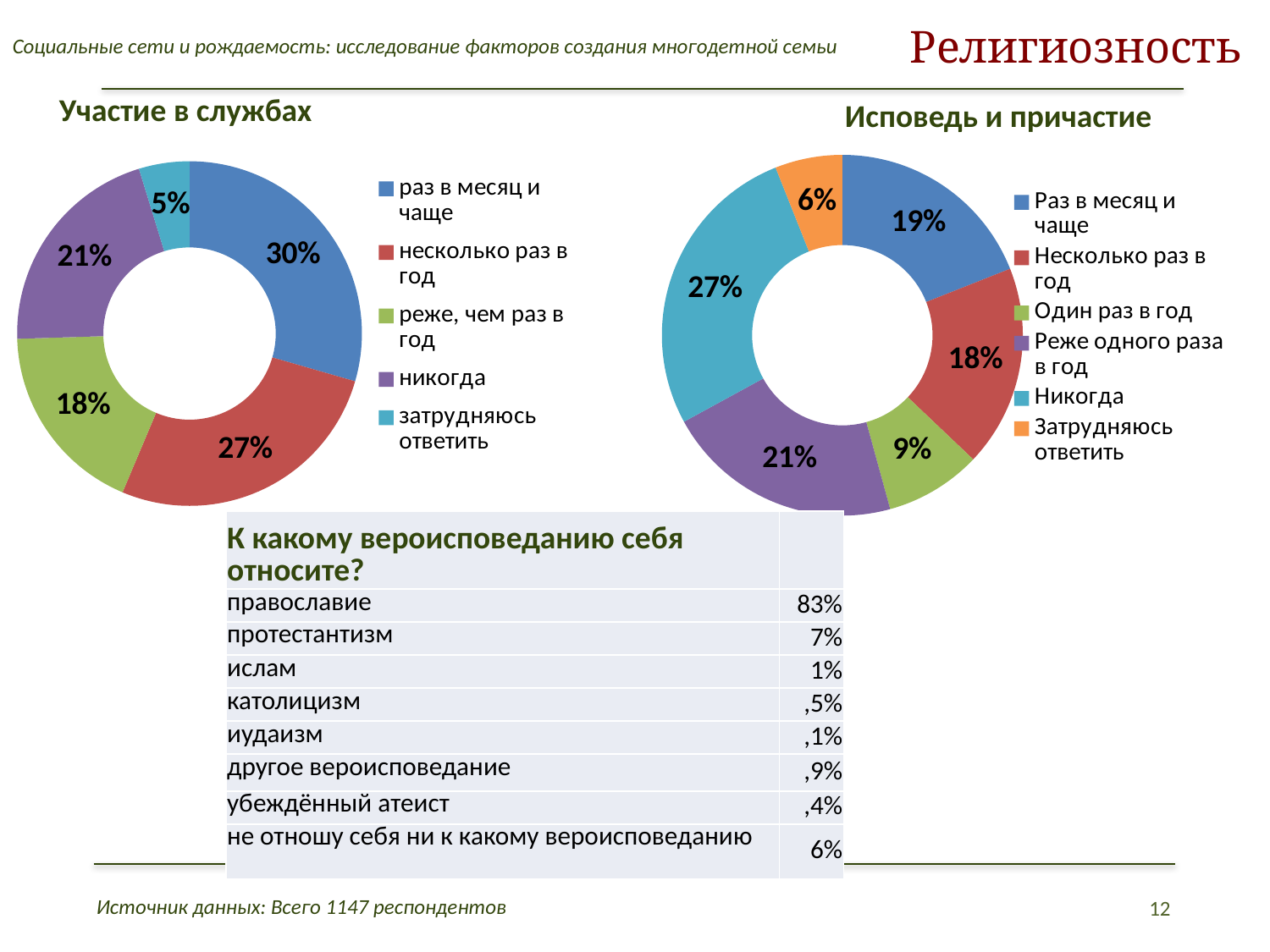
What type of chart is used for 'Участие в службах'? Donut (pie) chart In the 'Участие в службах' chart, which category has the smallest share? затрудняюсь ответить In the 'Исповедь и причастие' chart, which is larger: 'Раз в месяц и чаще' or 'Реже одного раза в год'? Реже одного раза в год In the 'Участие в службах' chart, what is the difference between 'несколько раз в год' and 'реже, чем раз в год'? 9% In the 'Исповедь и причастие' chart, what share of respondents answered 'Никогда'? 27% How many categories does the legend of the 'Исповедь и причастие' chart list? 6 In the 'Участие в службах' chart, what share of respondents answered 'никогда'? 21% In the 'Исповедь и причастие' chart, what share of respondents answered 'Один раз в год'? 9% How many categories does the legend of the 'Участие в службах' chart list? 5 In the 'Участие в службах' chart, what share of respondents answered 'раз в месяц и чаще'? 30% In the 'Исповедь и причастие' chart, which category has the largest share? Никогда In the 'Участие в службах' chart, which category has the largest share? раз в месяц и чаще